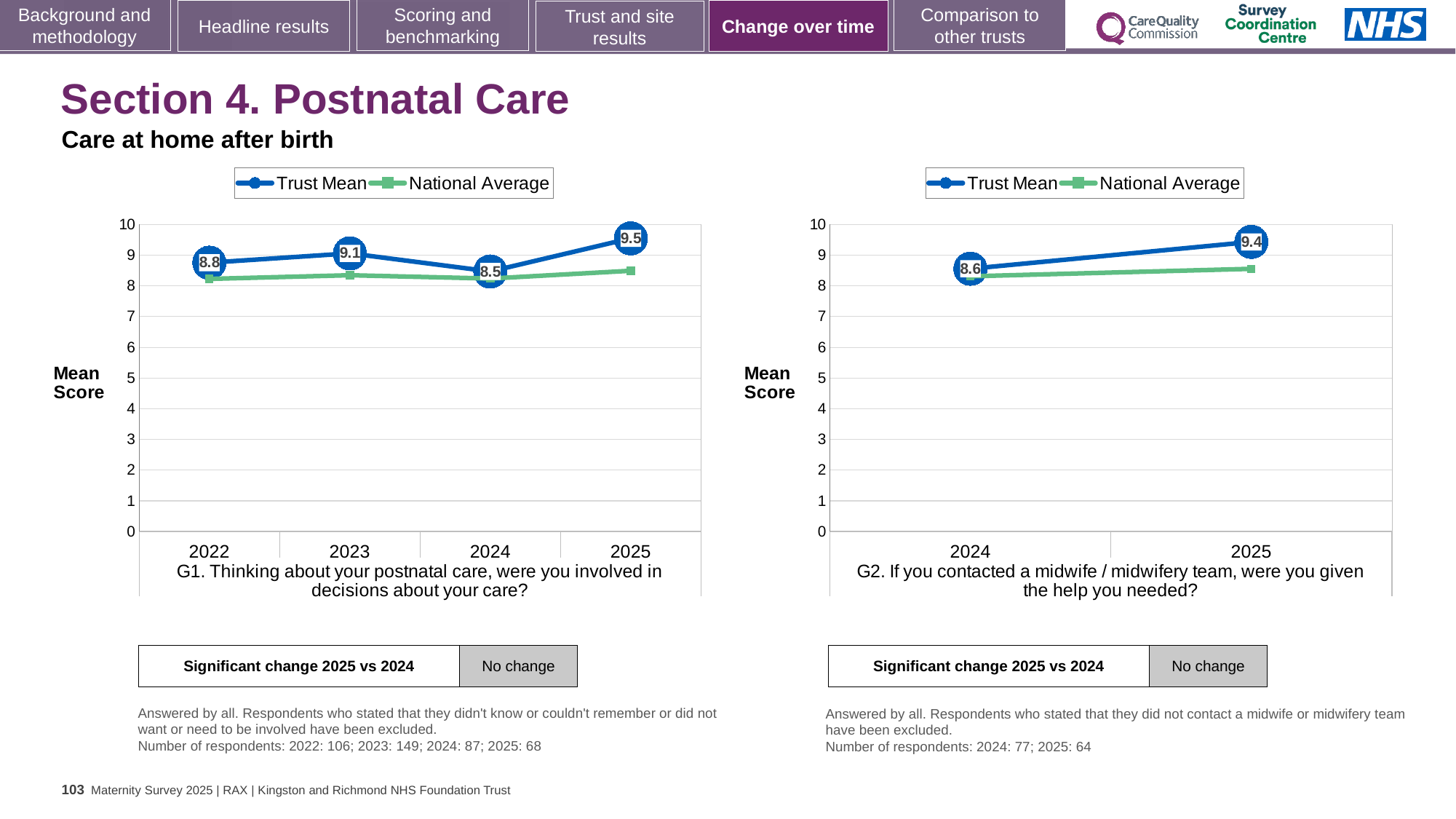
In the G1 chart (left), is the Trust Mean higher in 2023 or in 2022? 2023 How many years are shown on the x axis of the G1 chart (left)? 4 In the G1 chart (left), what is the difference between the Trust Mean in 2025 and in 2024? 1.0 In the G1 chart (left), which year has the highest Trust Mean? 2025 In the G1 chart (left), which year has the lowest Trust Mean? 2024 In the G1 chart (left), what is the Trust Mean for 2022? 8.8 In the G2 chart (right), what is the difference between the Trust Mean in 2025 and in 2024? 0.8 In the G2 chart (right), is the National Average for 2025 greater or less than 9? less What kind of chart is the G2 chart (right)? Line chart In the G2 chart (right), what is the Trust Mean for 2024? 8.6 In the G1 chart (left), what is the Trust Mean for 2025? 9.5 How many series does the legend of the G2 chart (right) list? 2